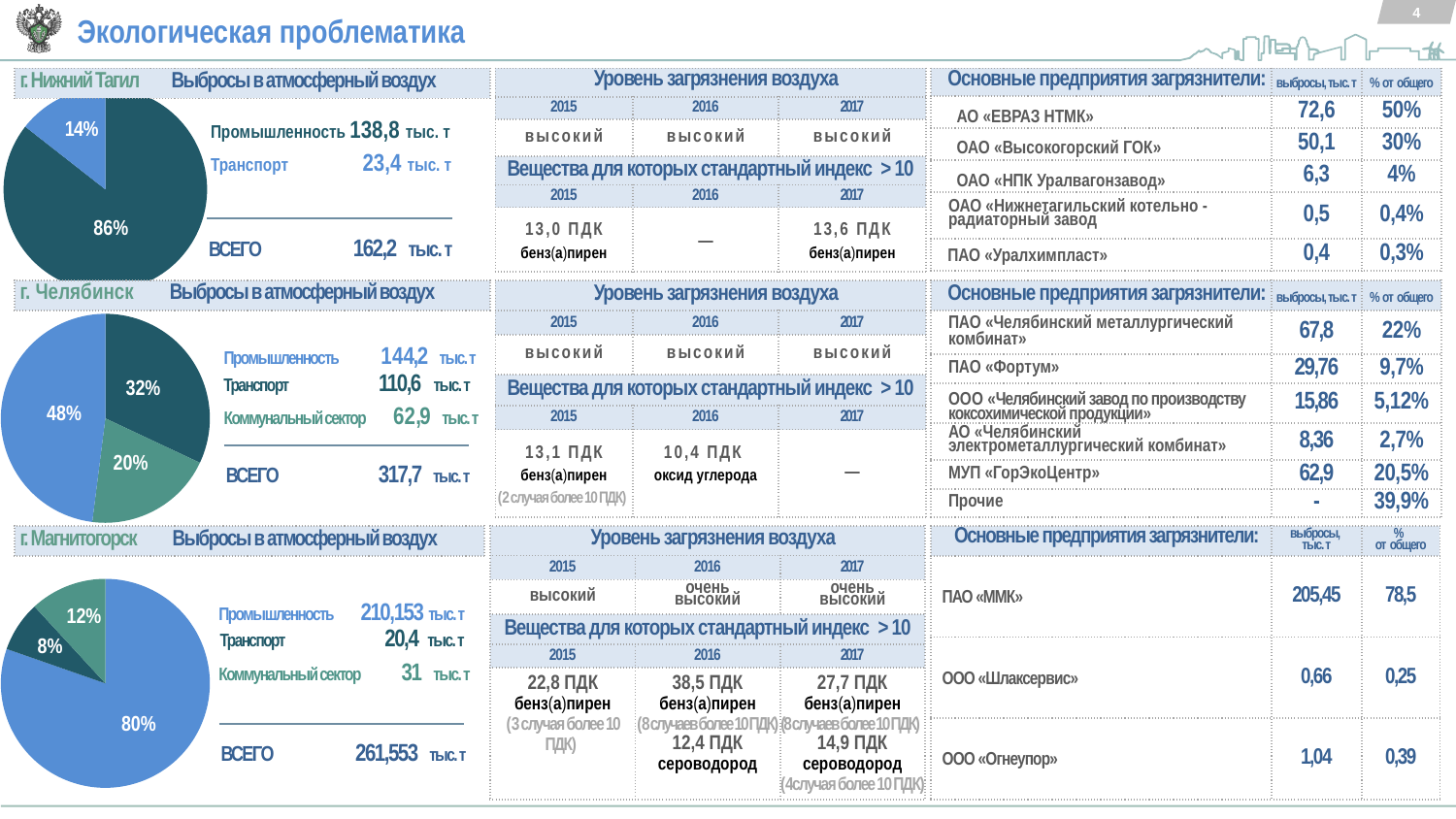
In the Chelyabinsk pie chart (middle), what is the largest share shown? 48% In the Chelyabinsk pie chart (middle), what is the smallest share shown? 20% In the Magnitogorsk pie chart (bottom), which is larger: the 12% slice or the 8% slice? 12% How many slices does the Nizhny Tagil pie chart (top) have? 2 How many pie charts are on the slide? 3 How many slices does the Chelyabinsk pie chart (middle) have? 3 In the Magnitogorsk pie chart (bottom), what is the smallest share shown? 8% In the Nizhny Tagil pie chart (top), what share of emissions does the largest slice represent? 86% What type of chart is used to show emissions into the atmosphere for each city on the slide? Pie chart In the Nizhny Tagil pie chart (top), what share is shown for the smaller slice? 14% In the Chelyabinsk pie chart (middle), what is the difference between the 48% slice and the 32% slice? 16% In the Magnitogorsk pie chart (bottom), what share does the largest slice represent? 80%